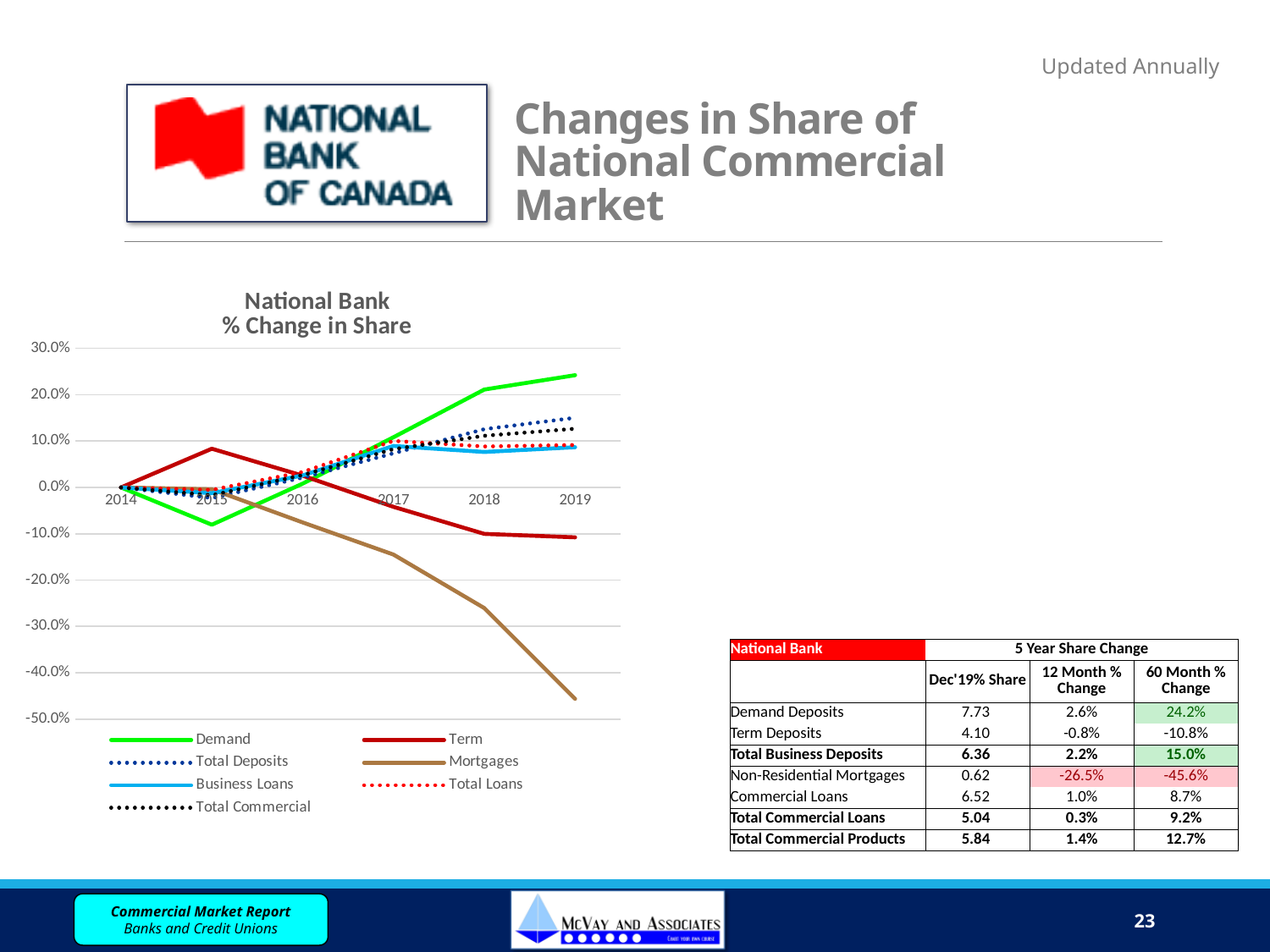
Is the value for Term in 2019 greater or less than 0.0%? less Does the Demand line rise or fall from 2015 to 2019? rise Is the value for Mortgages in 2019 greater or less than -40.0%? less In 2019, which is larger on the chart: Demand or Term? Demand What is the title of the chart? National Bank % Change in Share Which series has the lowest value in 2019 on the chart? Mortgages Is the value for Demand in 2019 greater or less than 20.0%? greater Does the Mortgages line rise or fall from 2016 to 2019? fall How many series does the legend of the National Bank % Change in Share chart list? 7 How many years are shown along the x axis of the chart? 6 What kind of chart is shown on the slide? line chart Which series has the highest value in 2019 on the chart? Demand